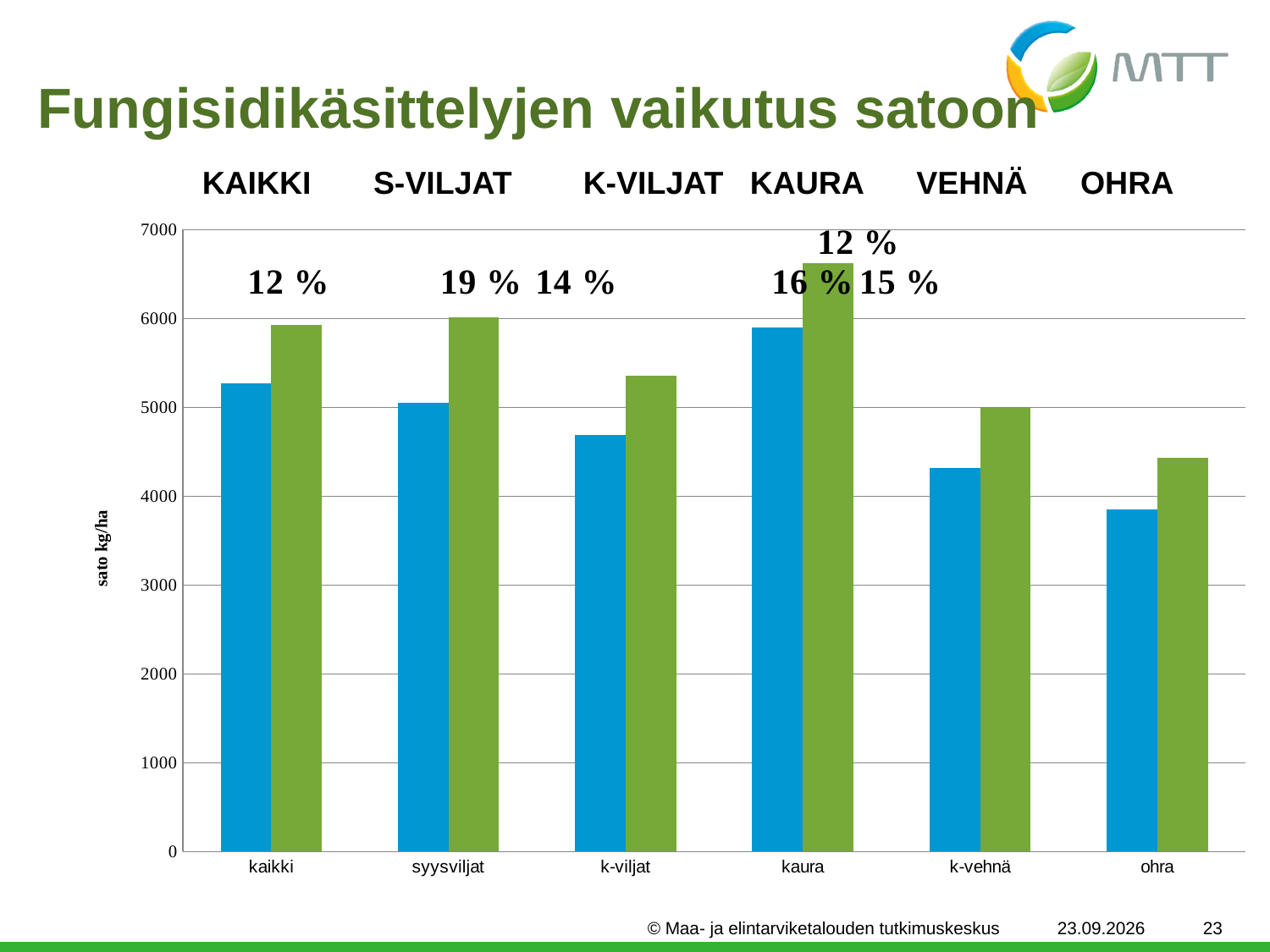
What is the title of the slide containing the chart? Fungisidikäsittelyjen vaikutus satoon What percentage is printed above the bars for KAIKKI? 12 % Which category has the highest percentage label printed above its bars? S-VILJAT For k-vehnä, which bar is taller, the blue one or the green one? the green one What is the y-axis label of the chart? sato kg/ha Which bar in the chart is the shortest? the blue bar for ohra Is the value of the blue bar for ohra greater or less than 4000? less Which bar in the chart is the tallest? the green bar for kaura What kind of chart is shown on the slide? bar chart What percentage is printed above the bars for S-VILJAT? 19 % How many categories are shown on the x axis of the chart? 6 Is the value of the green bar for kaura greater or less than 6000? greater